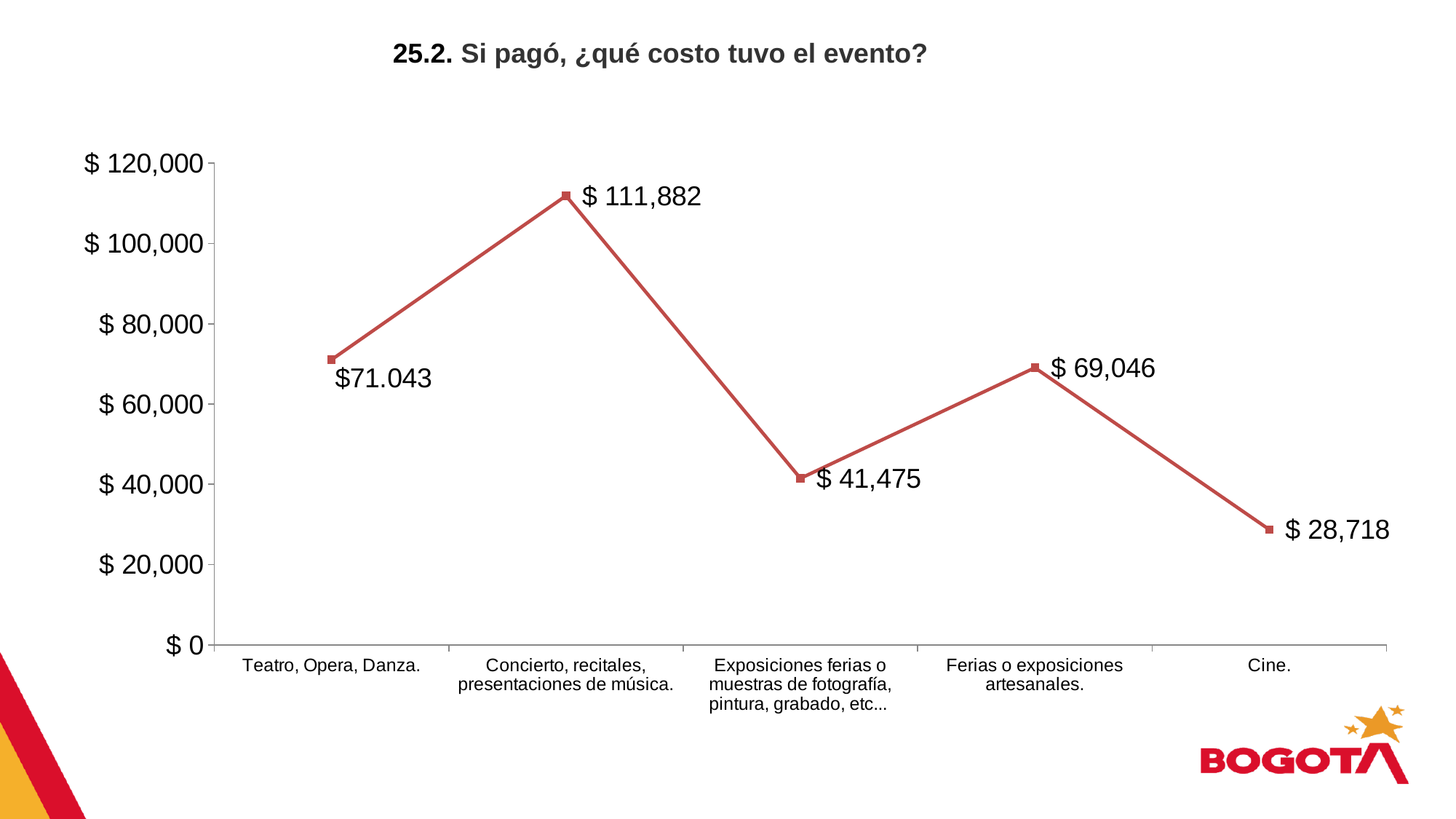
What kind of chart is shown on the slide? line chart What is the difference between the values for Exposiciones ferias o muestras de fotografía, pintura, grabado, etc... and Cine? $ 12,757 Which category has the lowest value? Cine. Which is larger, the value for Teatro, Opera, Danza or the value for Ferias o exposiciones artesanales? Teatro, Opera, Danza. What is the value shown for Cine? $ 28,718 How many categories are plotted on the x axis? 5 What is the difference between the values for Concierto, recitales, presentaciones de música and Ferias o exposiciones artesanales? $ 42,836 What is the value shown for Ferias o exposiciones artesanales? $ 69,046 Is the value for Teatro, Opera, Danza greater or less than $ 60,000? greater Which category has the highest value? Concierto, recitales, presentaciones de música. What is the value shown for Concierto, recitales, presentaciones de música? $ 111,882 What is the value shown for Exposiciones ferias o muestras de fotografía, pintura, grabado, etc...? $ 41,475